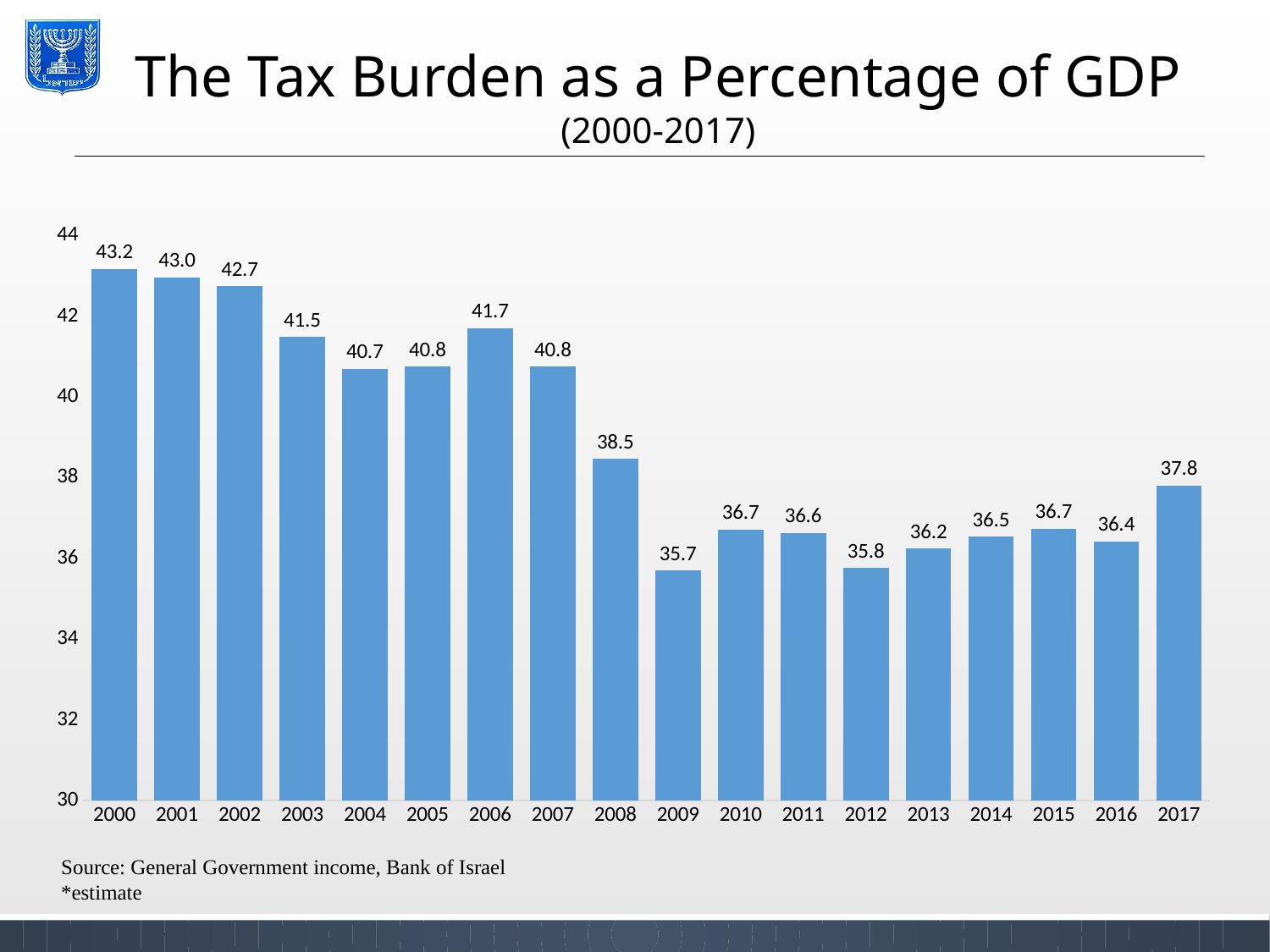
Which year had a higher tax burden, 2006 or 2008? 2006 Did the tax burden as a percentage of GDP generally rise or fall from 2000 to 2009? Fall What is the difference between the tax burden in 2000 and in 2017? 5.4 What was the tax burden as a percentage of GDP in 2009? 35.7 What was the tax burden as a percentage of GDP in 2000? 43.2 Which year has the highest tax burden as a percentage of GDP? 2000 What was the tax burden as a percentage of GDP in 2017? 37.8 How many years are shown on the chart? 18 What is the difference between the tax burden in 2007 and in 2008? 2.3 What kind of chart is shown on the slide? Bar chart Is the value for 2012 greater or less than 36? less Which year has the lowest tax burden as a percentage of GDP? 2009